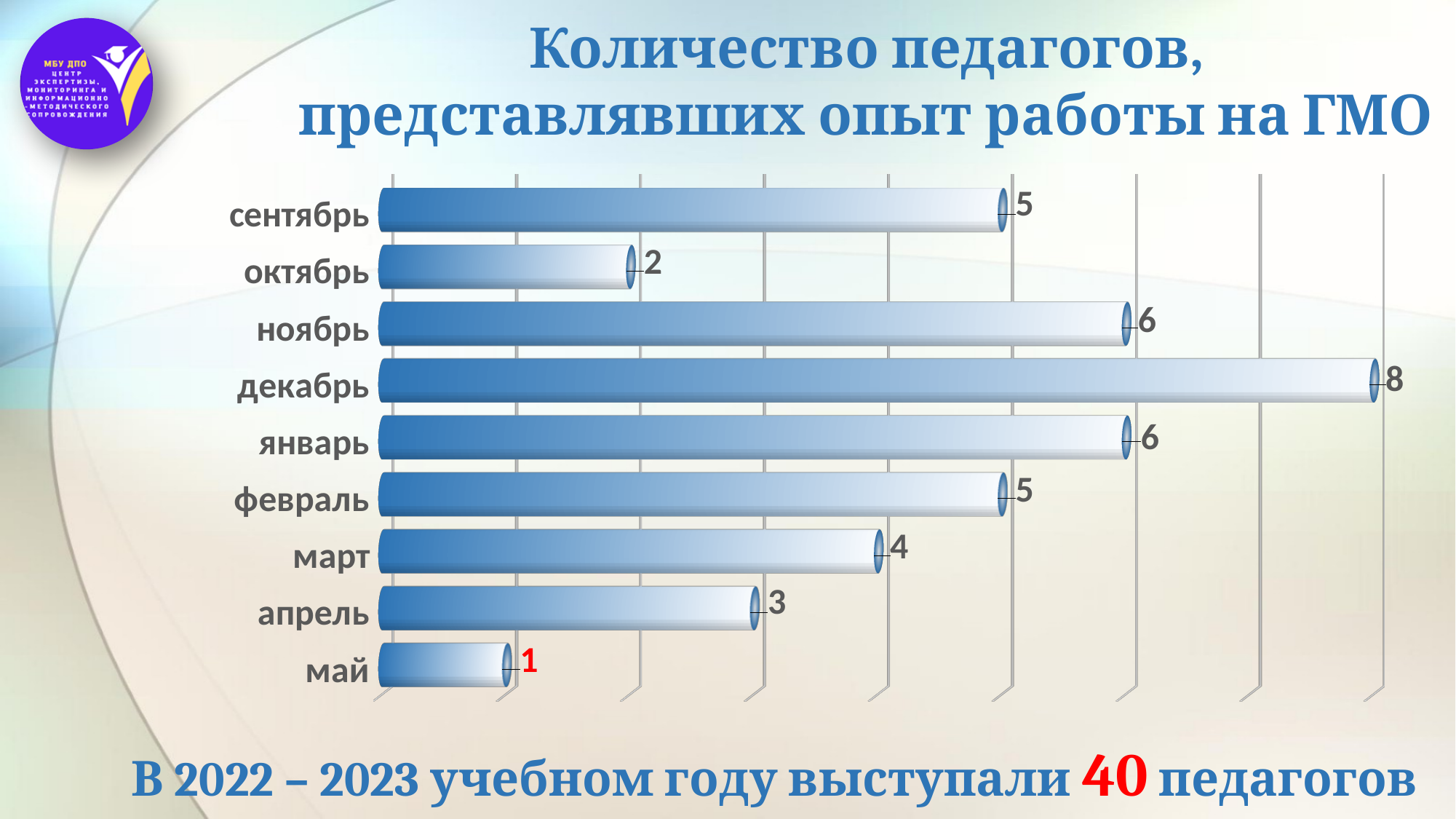
Which month has the lowest value? май What kind of chart is shown on the slide? bar chart Do the values rise or fall from февраль to май? fall What is the difference between the values for ноябрь and апрель? 3 What is the value for март? 4 What is the value for октябрь? 2 Which month has the highest value? декабрь Which data label is shown in red? май (1) Which is larger, the value for сентябрь or the value for март? сентябрь How many months are shown in the chart? 9 What is the value for декабрь? 8 What is the difference between the values for декабрь and май? 7